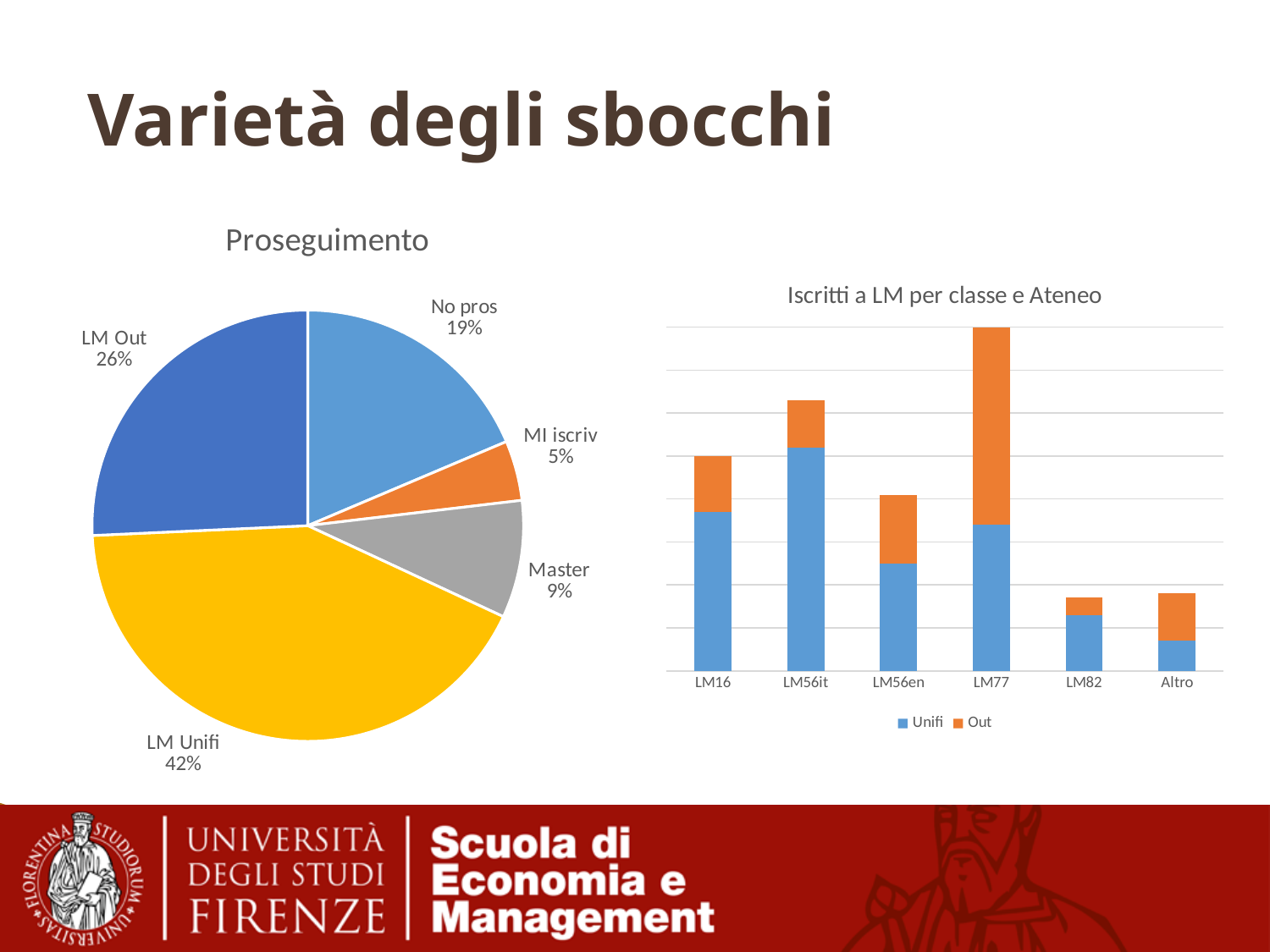
What kind of chart is 'Iscritti a LM per classe e Ateneo' on the right? Stacked bar chart In the Proseguimento pie chart, which slice is the largest? LM Unifi How many categories are shown on the x axis of the 'Iscritti a LM per classe e Ateneo' chart? 6 In the Proseguimento pie chart, what percentage is shown for No pros? 19% In the Proseguimento pie chart, which slice is the smallest? MI iscriv In the 'Iscritti a LM per classe e Ateneo' chart, which category has the tallest stacked bar? LM77 How many series does the legend of the 'Iscritti a LM per classe e Ateneo' chart list? 2 How many slices does the Proseguimento pie chart have? 5 In the 'Iscritti a LM per classe e Ateneo' chart, is the total bar for LM56it or LM56en taller? LM56it In the Proseguimento pie chart, what share does LM Unifi have? 42% What kind of chart is the Proseguimento chart on the left? Pie chart In the Proseguimento pie chart, what is the difference in percentage points between LM Out and No pros? 7 percentage points